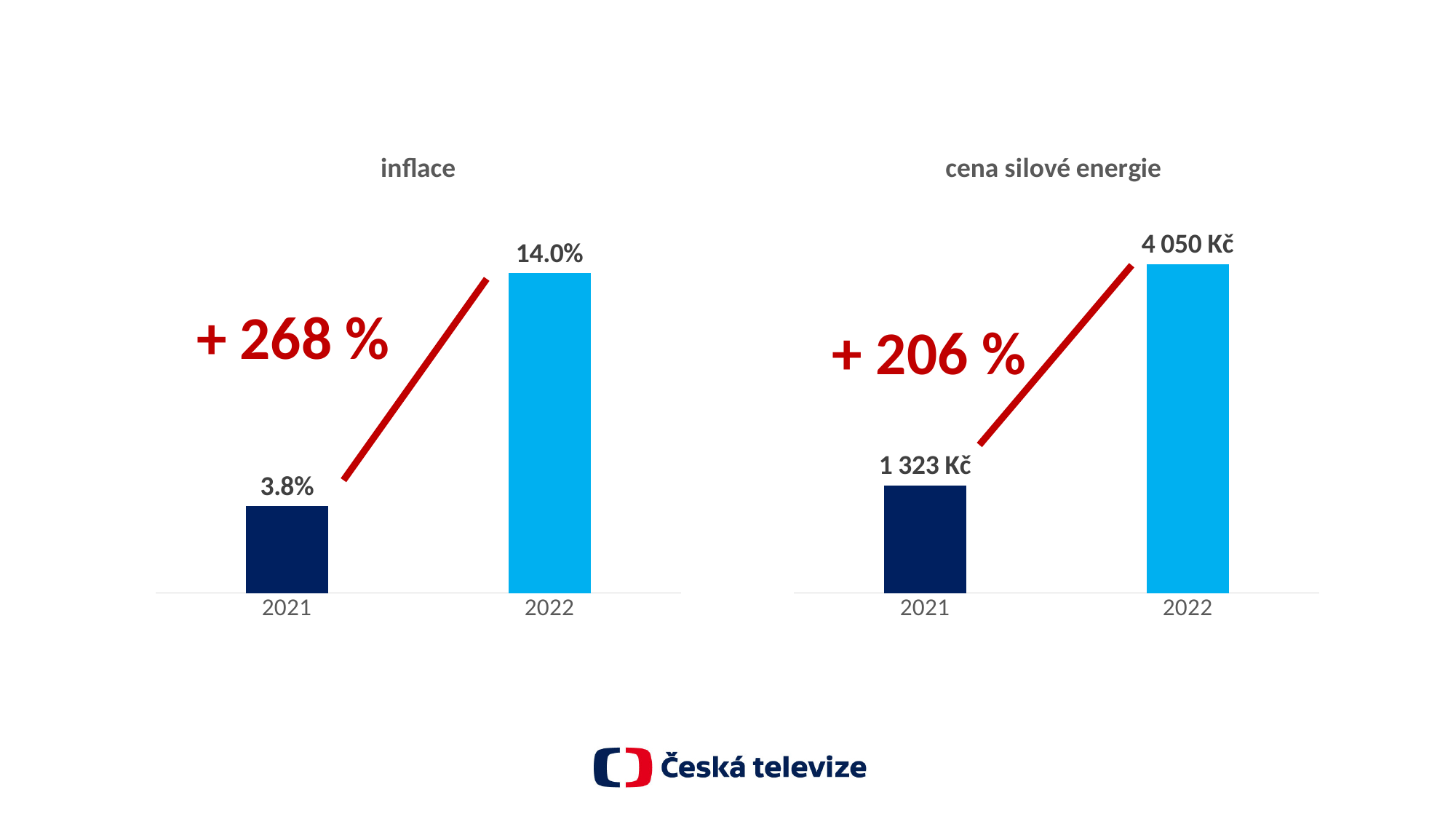
In the 'inflace' chart, what is the value for 2022? 14.0% In the 'inflace' chart, which year has the higher value? 2022 How many categories are shown in the 'cena silové energie' chart? 2 In the 'cena silové energie' chart, which year has the lower value? 2021 What kind of chart is the 'inflace' chart? Bar chart In the 'cena silové energie' chart, what is the difference between the 2022 and 2021 values? 2 727 Kč What percentage increase is annotated in red on the 'inflace' chart? + 268 % In the 'cena silové energie' chart, do the values rise or fall from 2021 to 2022? Rise In the 'cena silové energie' chart, what is the value for 2021? 1 323 Kč In the 'cena silové energie' chart, what is the value for 2022? 4 050 Kč In the 'inflace' chart, what is the value for 2021? 3.8% In the 'inflace' chart, what is the difference between the 2022 and 2021 values? 10.2 percentage points